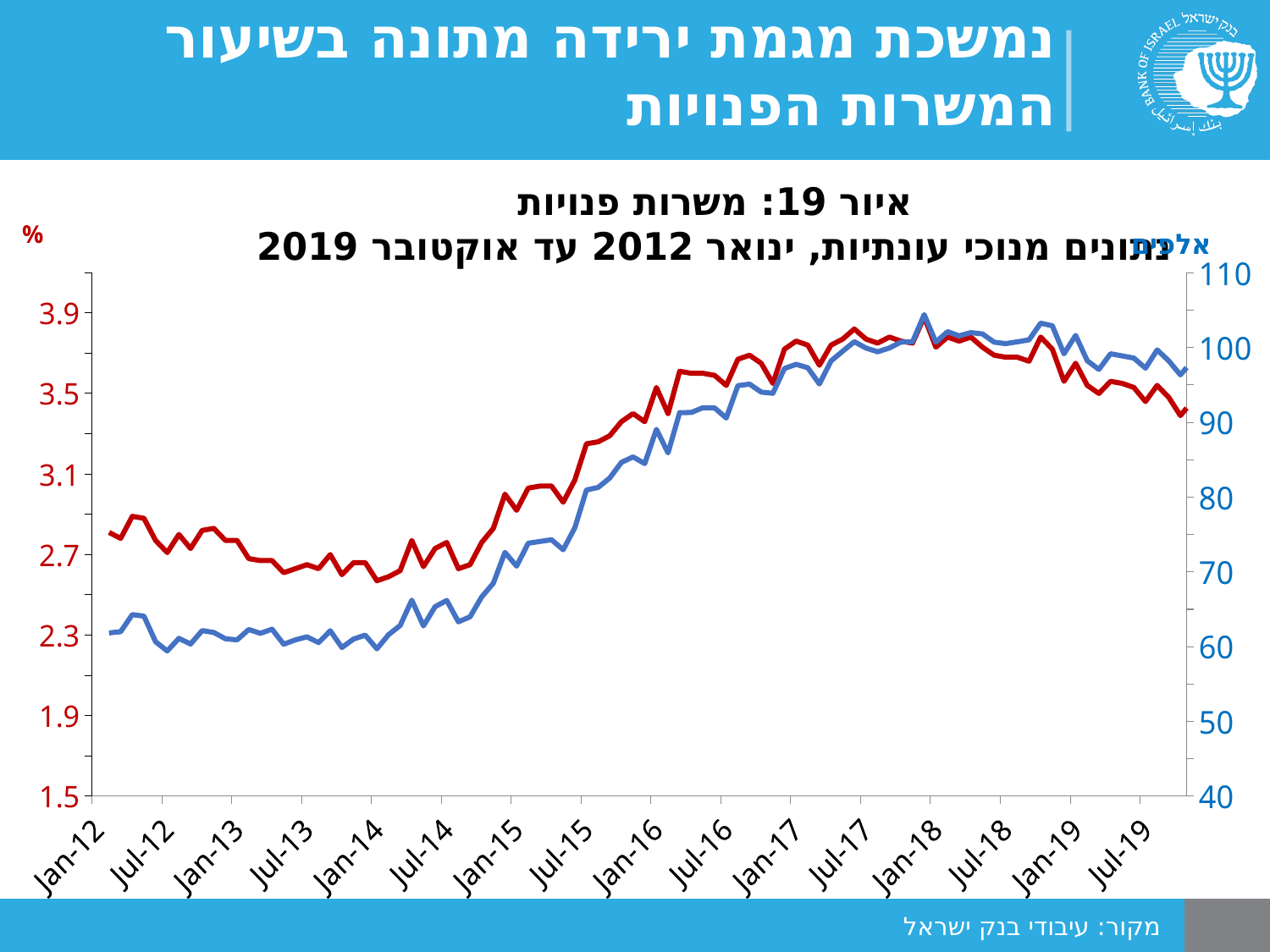
Does the red line rise or fall between Jan-18 and the end of the series in 2019? fall What kind of chart is shown on the slide? line chart Is the value of the blue line at Jan-15 greater or less than 70? greater Is the value of the red line at Jan-14 greater or less than 2.7? less Does the blue line rise or fall between Jan-14 and Jan-18? rise Is the value of the blue line at Jan-18 greater or less than 100? greater What is the title of the chart (figure number and name)? איור 19: משרות פנויות What unit label appears above the left (red) axis? % How many lines are plotted on the chart? 2